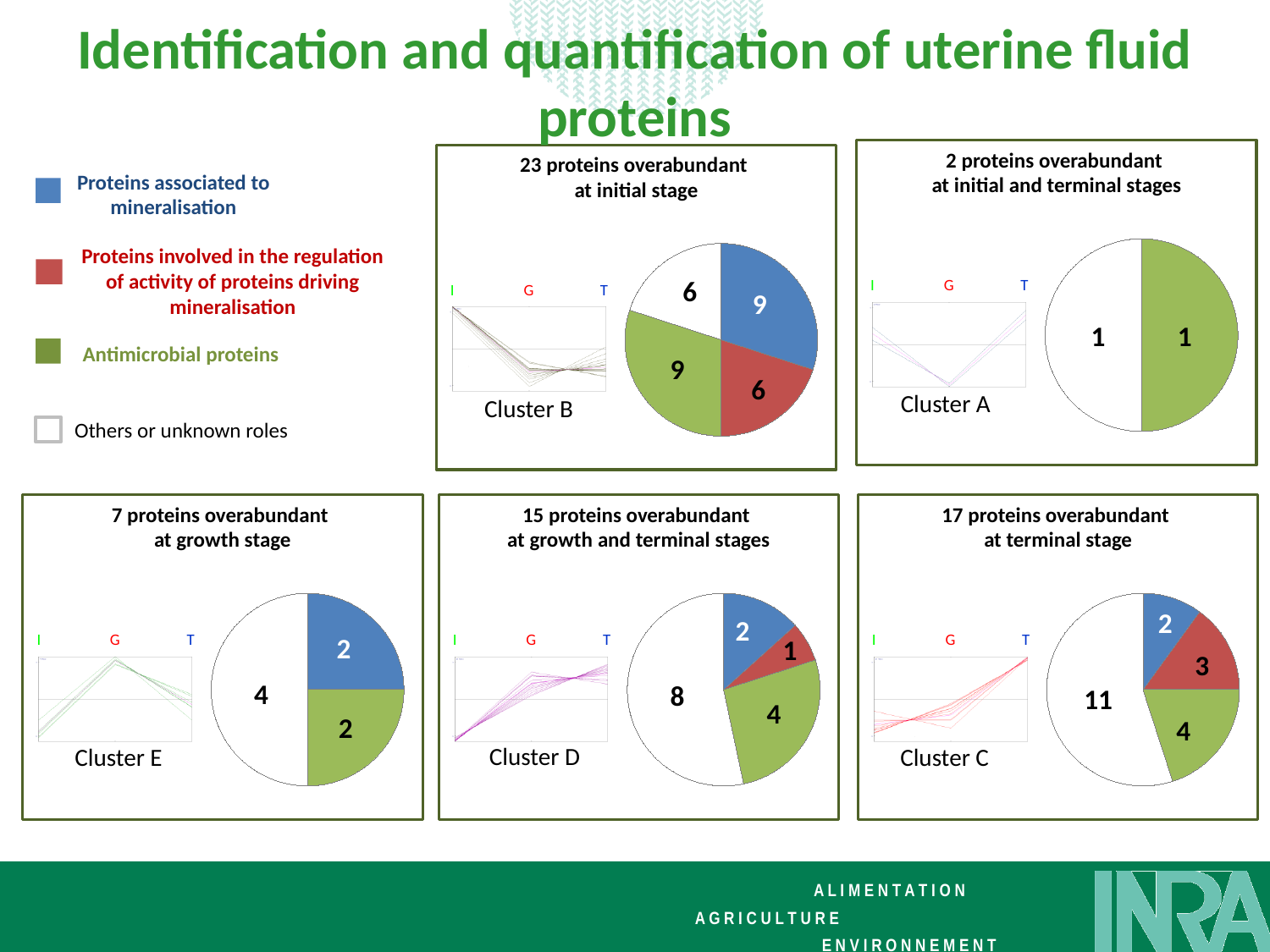
In the Cluster C pie chart, what is the value of the white slice (others or unknown roles)? 11 In the Cluster B pie chart, what is the value of the red slice (proteins involved in the regulation of activity of proteins driving mineralisation)? 6 In the Cluster C pie chart, what is the difference between the white slice and the green slice? 7 In the Cluster A pie chart, what share of the pie does the green slice represent? 50% What type of chart is used to show the protein categories in each cluster? Pie chart In the Cluster D pie chart, how many antimicrobial proteins (green slice) are shown? 4 In the Cluster C pie chart, which category has the largest slice? Others or unknown roles In the Cluster B pie chart, how many proteins are associated to mineralisation (blue slice)? 9 In the Cluster E pie chart, what is the value of the white slice? 4 In the Cluster D pie chart, which category has the smallest slice? Proteins involved in the regulation of activity of proteins driving mineralisation In the Cluster D pie chart, is the blue slice or the red slice larger? Blue slice How many slices does the Cluster A pie chart have? 2